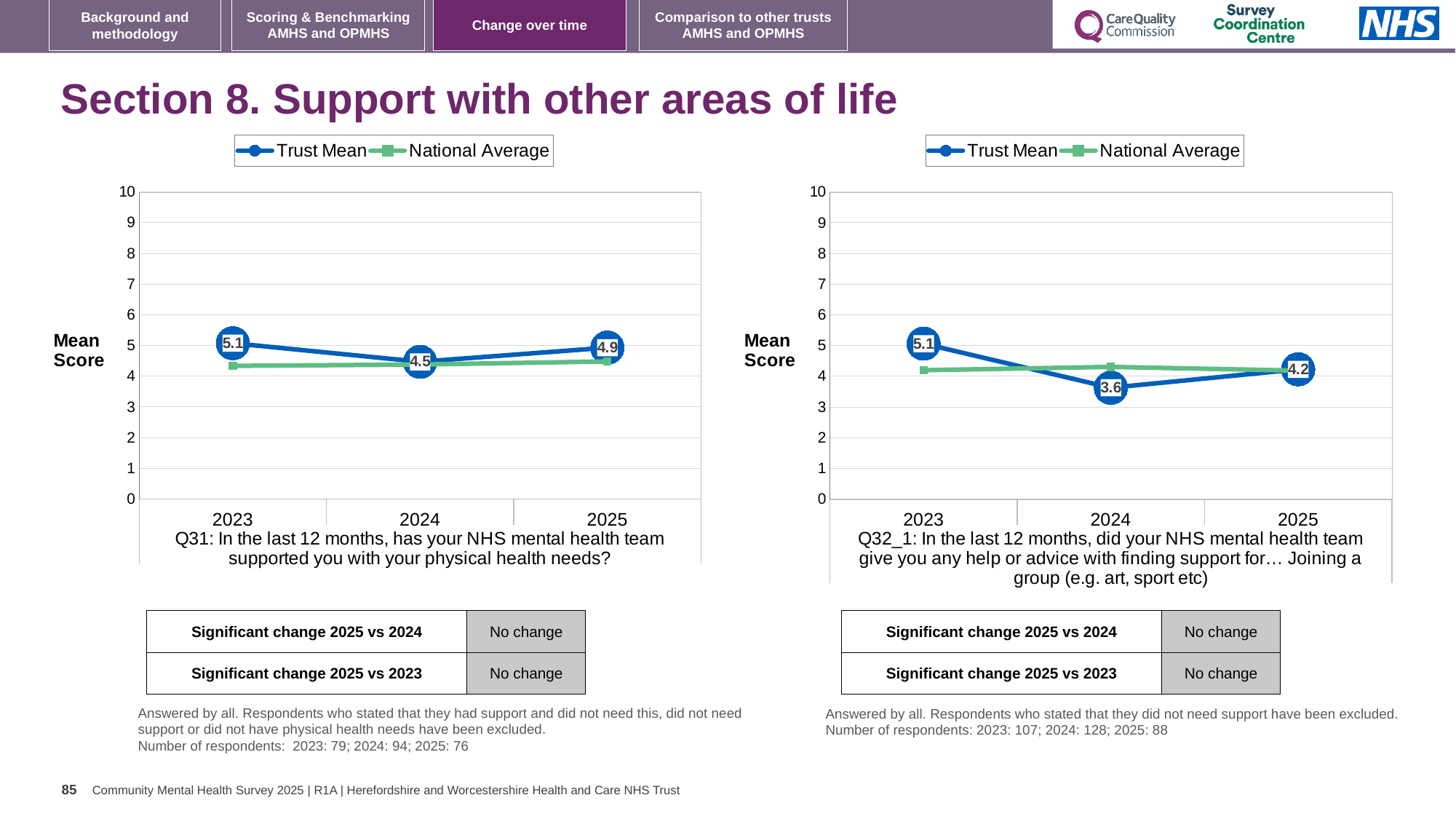
What kind of chart is the Q32_1 chart on the right? line chart In the Q31 chart on the left, what is the Trust Mean for 2023? 5.1 In the Q31 chart on the left, what is the Trust Mean for 2024? 4.5 In the Q31 chart on the left, what is the difference between the Trust Mean for 2025 and the Trust Mean for 2024? 0.4 In the Q32_1 chart on the right, what is the difference between the Trust Mean for 2023 and the Trust Mean for 2024? 1.5 In the Q31 chart on the left, is the Trust Mean for 2025 larger or smaller than the Trust Mean for 2024? larger In the Q32_1 chart on the right, which year has the lowest Trust Mean? 2024 In the Q32_1 chart on the right, is the National Average for 2024 greater or less than 5? less In the Q31 chart on the left, which year has the highest Trust Mean? 2023 In the Q32_1 chart on the right, what is the Trust Mean for 2025? 4.2 How many series does the legend of the Q31 chart on the left list? 2 In the Q32_1 chart on the right, does the Trust Mean rise or fall from 2023 to 2024? fall